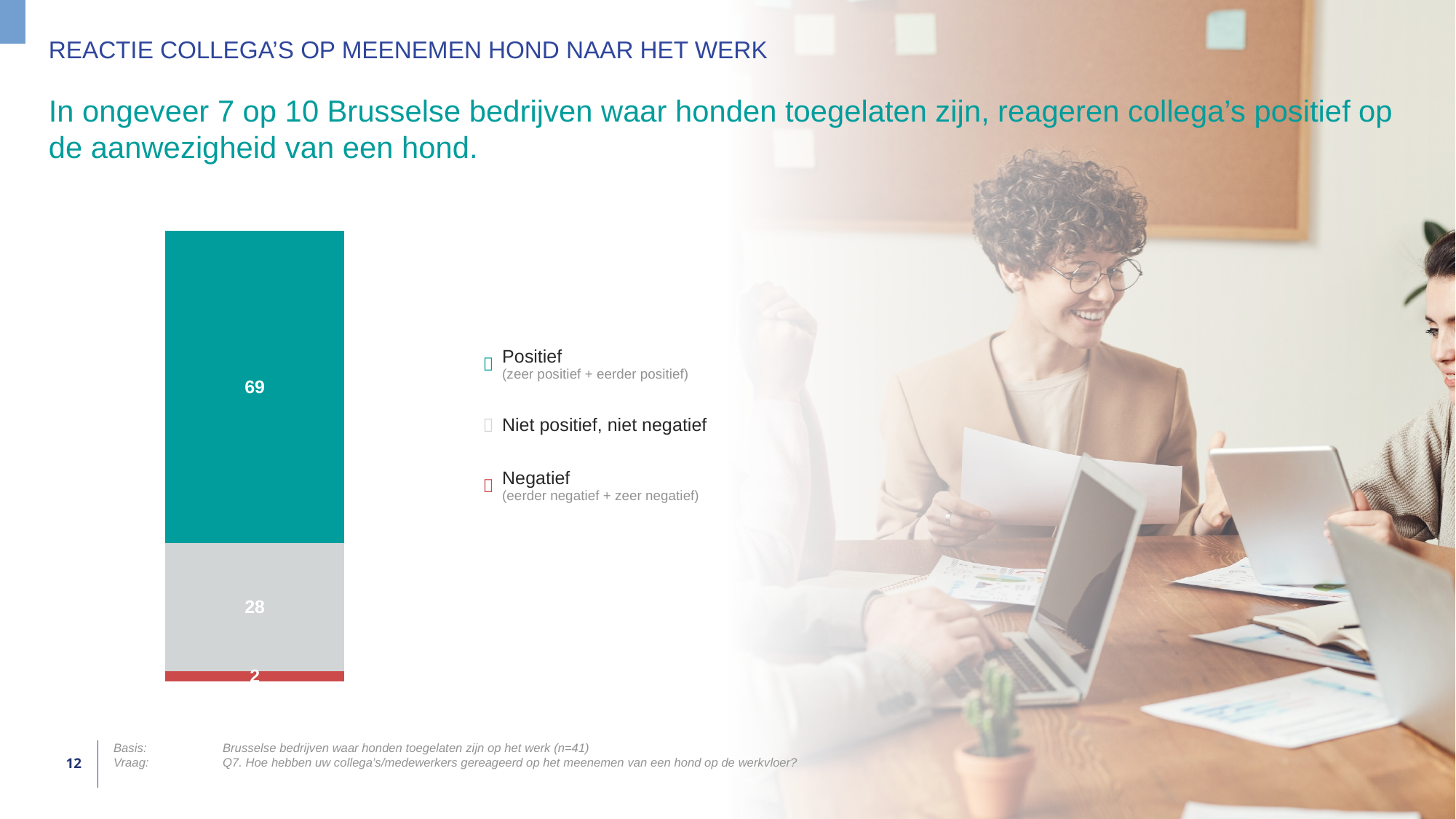
What value is shown for the Niet positief, niet negatief segment? 28 How many entries does the legend list? 3 What value is shown for the Negatief segment? 2 What is the difference between the Niet positief, niet negatief and Negatief values? 26 What kind of chart is shown on the slide? Stacked bar chart What is the difference between the Positief and Niet positief, niet negatief values? 41 What is the total of the three segments in the stacked bar? 99 What value is shown for the Positief segment of the stacked bar? 69 Which is larger, the Positief value or the Negatief value? Positief Which segment of the stacked bar has the highest value? Positief How many segments does the stacked bar contain? 3 Which segment of the stacked bar has the lowest value? Negatief